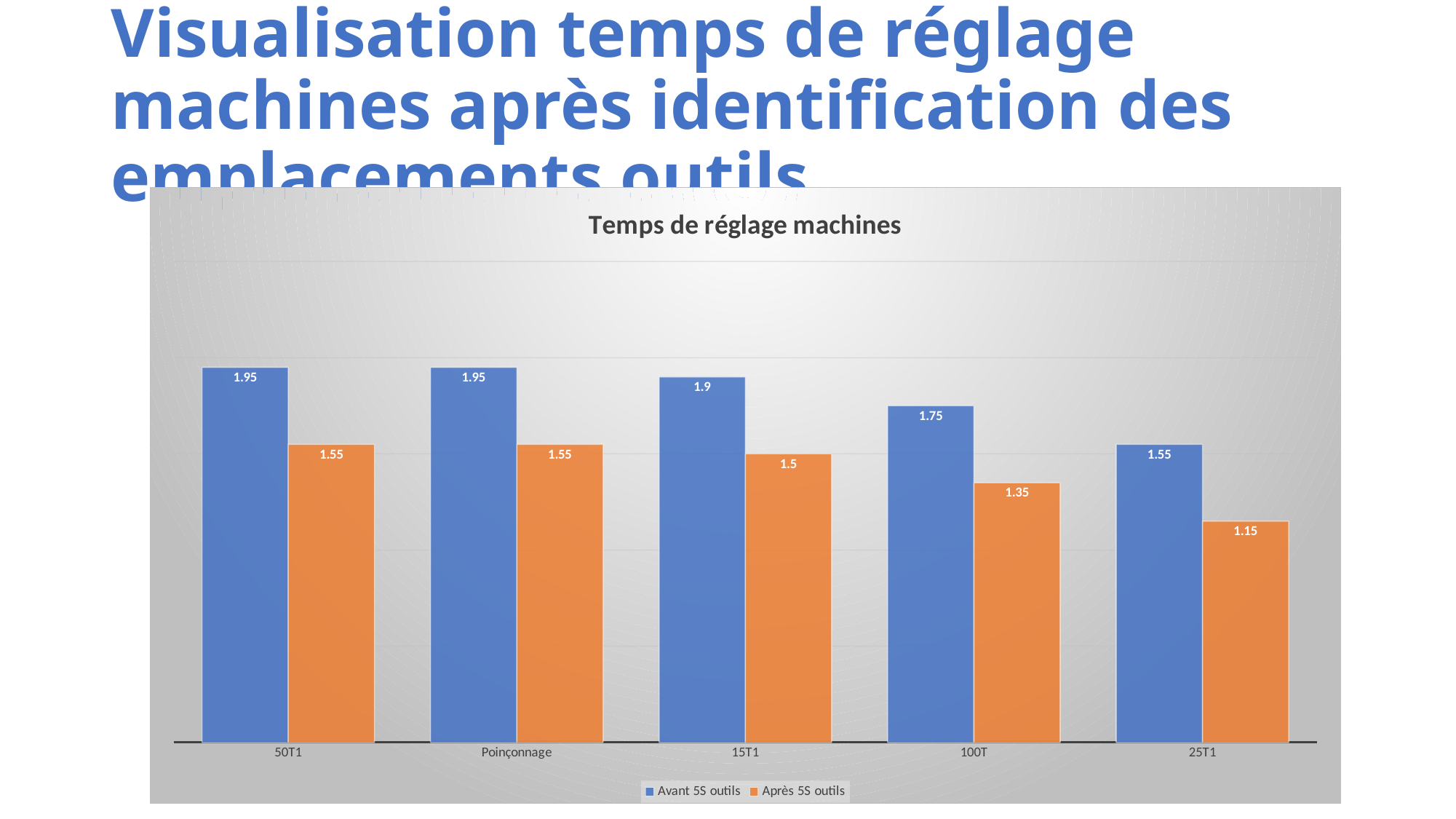
Which is larger: 'Après 5S outils' for 15T1 or 'Après 5S outils' for 100T? 15T1 How many series does the legend list? 2 What is the value for 'Après 5S outils' for 100T? 1.35 Which category has the lowest 'Après 5S outils' value? 25T1 What is the value for 'Après 5S outils' for 25T1? 1.15 What is the value for 'Avant 5S outils' for 50T1? 1.95 What is the difference between 'Avant 5S outils' and 'Après 5S outils' for 25T1? 0.4 What is the difference between 'Avant 5S outils' and 'Après 5S outils' for 100T? 0.4 What type of chart is shown? Bar chart Which category has the lowest 'Avant 5S outils' value? 25T1 How many categories are shown on the x axis? 5 What is the value for 'Avant 5S outils' for 15T1? 1.9